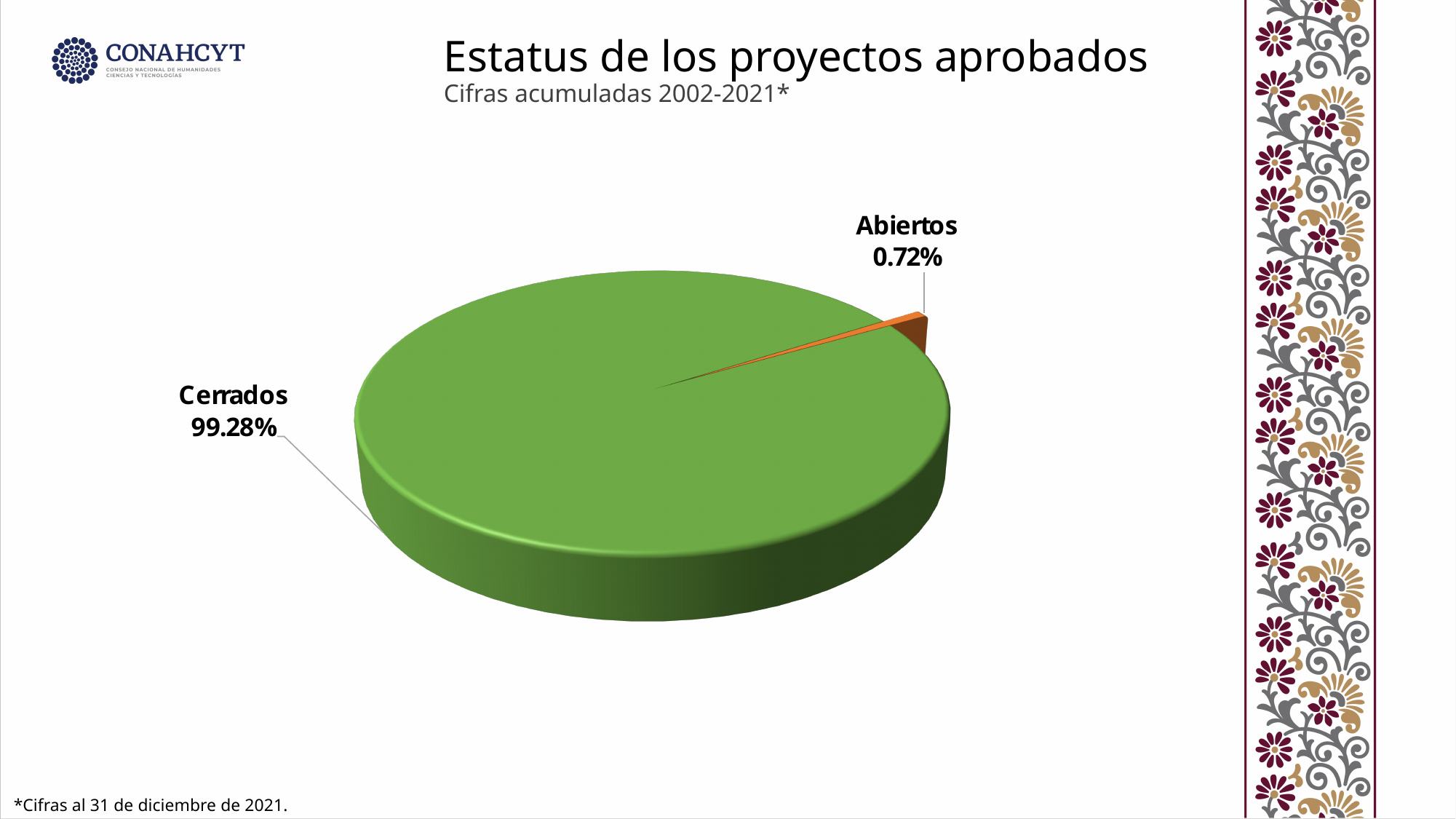
Which category has the smallest slice of the pie? Abiertos What is the title of the chart? Estatus de los proyectos aprobados What colour is the Abiertos slice? Orange Which category has the largest slice of the pie? Cerrados How many categories are shown in the pie chart? 2 What is the total of the two slices shown? 100% What share of the pie does Cerrados represent? 99.28% What kind of chart is shown on the slide? Pie chart What share of the pie does Abiertos represent? 0.72% Which is larger, the share for Cerrados or the share for Abiertos? Cerrados What is the difference in percentage points between Cerrados and Abiertos? 98.56